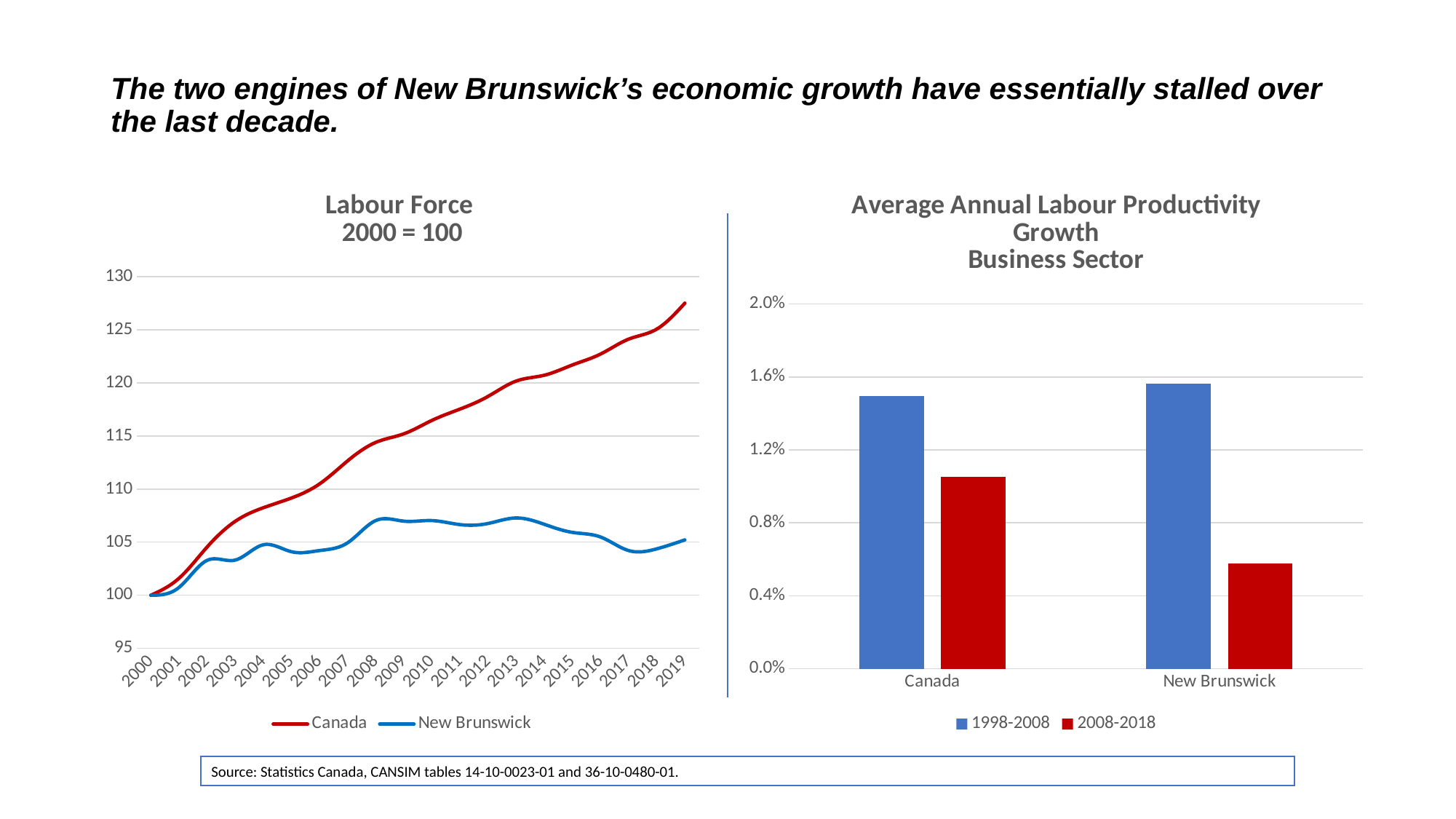
In the 'Labour Force 2000 = 100' chart, which series is higher in 2019, Canada or New Brunswick? Canada In the 'Average Annual Labour Productivity Growth Business Sector' chart, which period has the larger value for Canada, 1998-2008 or 2008-2018? 1998-2008 In the 'Average Annual Labour Productivity Growth Business Sector' chart, how many categories are shown on the x axis? 2 In the 'Average Annual Labour Productivity Growth Business Sector' chart, which colour represents the 2008-2018 series? red In the 'Labour Force 2000 = 100' chart, does the Canada line generally rise or fall from 2000 to 2019? rise What kind of chart is the 'Labour Force 2000 = 100' chart on the left? line chart In the 'Average Annual Labour Productivity Growth Business Sector' chart, is the 2008-2018 value for New Brunswick greater or less than 0.8%? less In the 'Labour Force 2000 = 100' chart, how many series does the legend list? 2 In the 'Labour Force 2000 = 100' chart, what is the value for Canada in 2000? 100 In the 'Labour Force 2000 = 100' chart, is the value for New Brunswick in 2019 greater or less than 110? less In the 'Labour Force 2000 = 100' chart, is the value for Canada in 2019 greater or less than 125? greater What kind of chart is the 'Average Annual Labour Productivity Growth Business Sector' chart on the right? bar chart